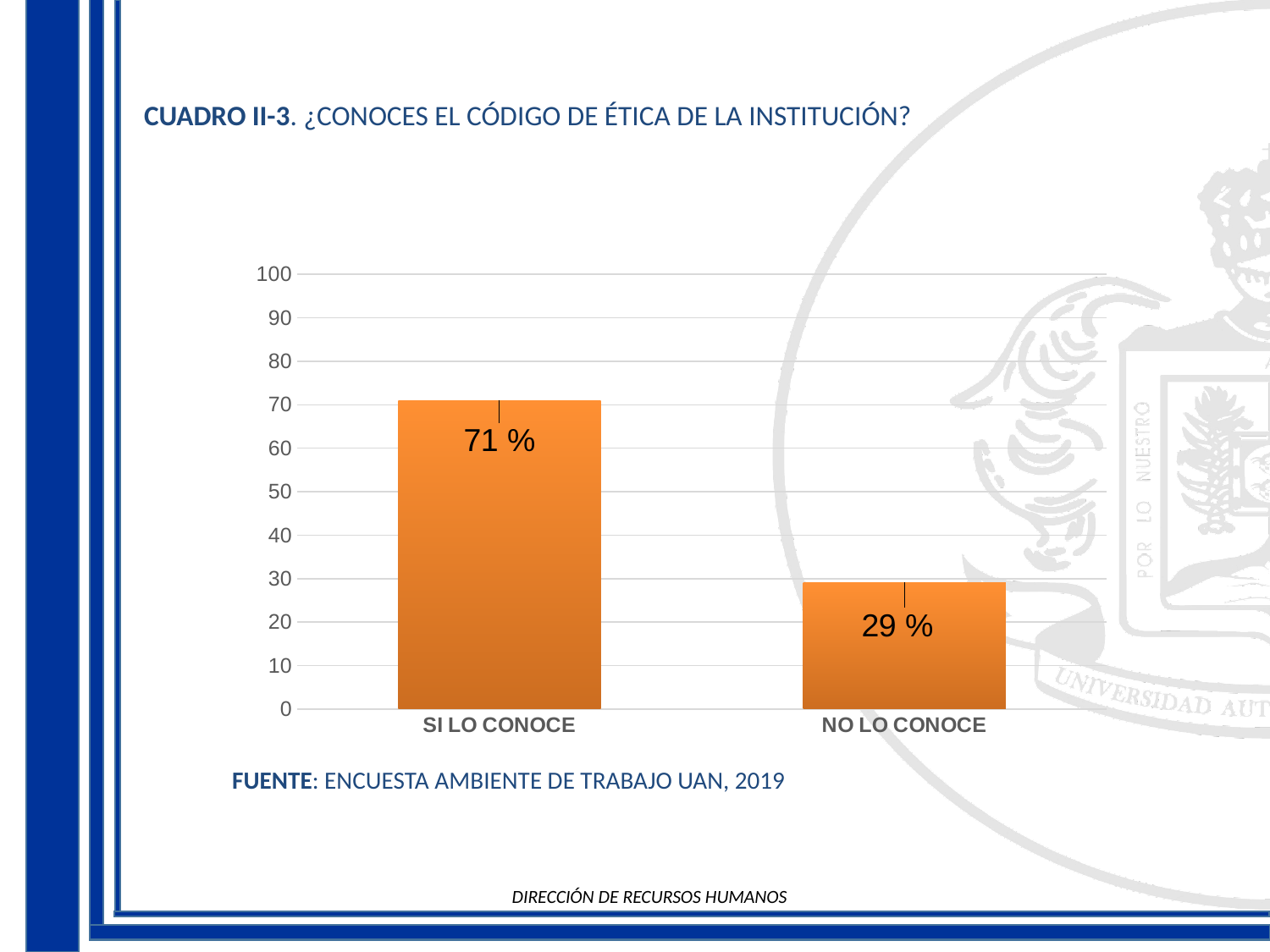
What is the value for NO LO CONOCE? 29 % Which is larger, the value for SI LO CONOCE or NO LO CONOCE? SI LO CONOCE What is the value for SI LO CONOCE? 71 % Which category has the highest value? SI LO CONOCE Which category has the lowest value? NO LO CONOCE Is the value for SI LO CONOCE greater or less than 60? greater What is the difference between the values for SI LO CONOCE and NO LO CONOCE? 42 % How many categories are shown on the x axis? 2 What kind of chart is shown on the slide? bar chart Is the value for NO LO CONOCE greater or less than 50? less What is the maximum value shown on the y axis? 100 What source is cited below the chart? ENCUESTA AMBIENTE DE TRABAJO UAN, 2019